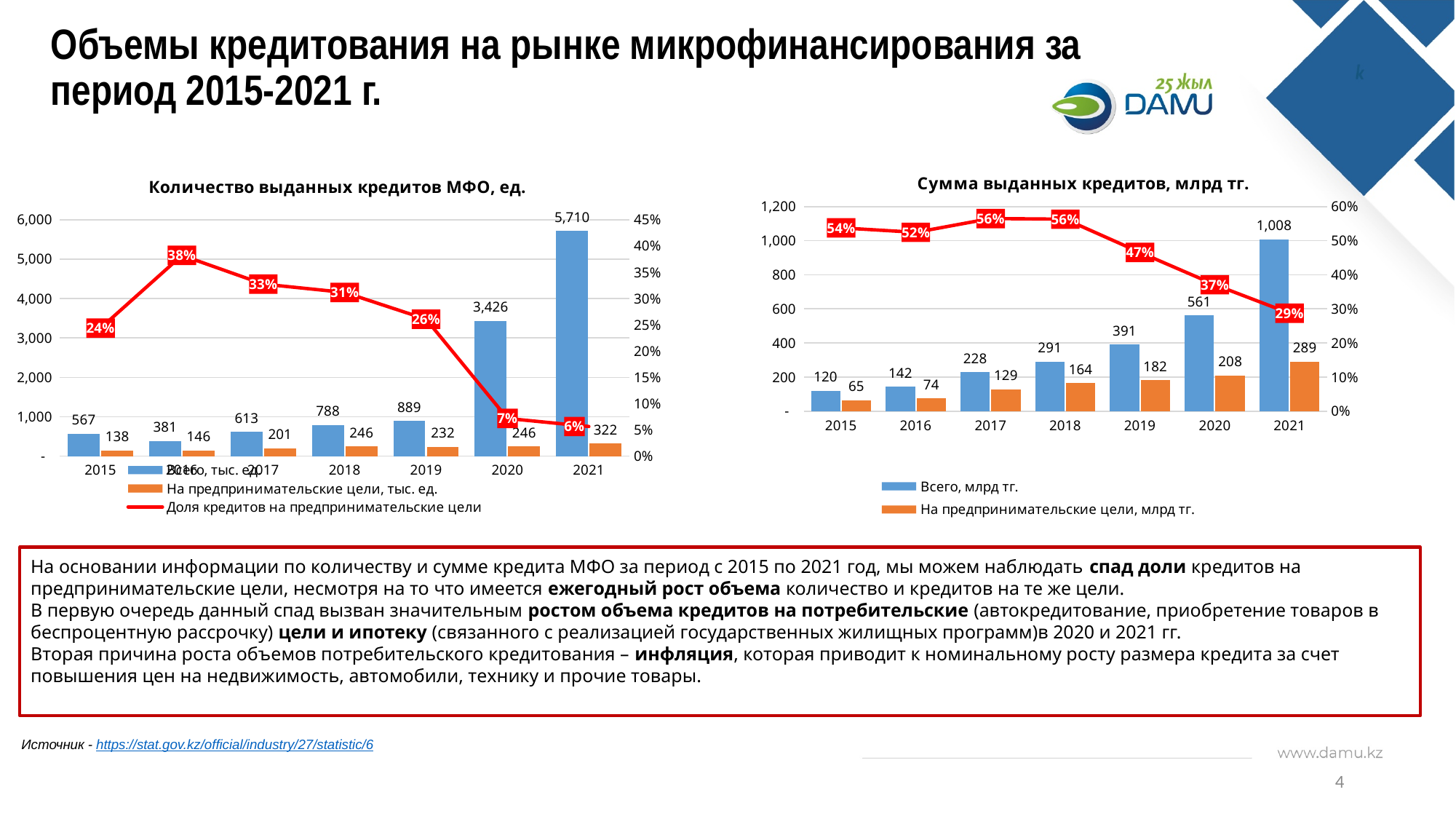
In the chart 'Сумма выданных кредитов, млрд тг.', which year has the lowest 'Всего, млрд тг.' value? 2015 In the chart 'Сумма выданных кредитов, млрд тг.', what is the 'Всего, млрд тг.' value for 2019? 391 In the chart 'Количество выданных кредитов МФО, ед.', in which year is the 'Доля кредитов на предпринимательские цели' line highest? 2016 In the chart 'Сумма выданных кредитов, млрд тг.', what is the percentage shown on the red line for 2020? 37% In the chart 'Количество выданных кредитов МФО, ед.', what is the value of 'На предпринимательские цели, тыс. ед.' for 2018? 246 In the chart 'Сумма выданных кредитов, млрд тг.', how many years are shown on the x axis? 7 In the chart 'Сумма выданных кредитов, млрд тг.', does the red percentage line rise or fall from 2018 to 2021? fall In the chart 'Количество выданных кредитов МФО, ед.', what is the difference between the 'Всего' values for 2021 and 2020? 2,284 In the chart 'Сумма выданных кредитов, млрд тг.', which is larger: 'Всего' for 2017 or 'На предпринимательские цели' for 2021? На предпринимательские цели for 2021 In the chart 'Сумма выданных кредитов, млрд тг.', what is the 'На предпринимательские цели, млрд тг.' value for 2021? 289 In the chart 'Количество выданных кредитов МФО, ед.', how many entries does the legend list? 3 In the chart 'Количество выданных кредитов МФО, ед.', what is the value of the 'Всего, тыс. ед.' bar for 2021? 5,710